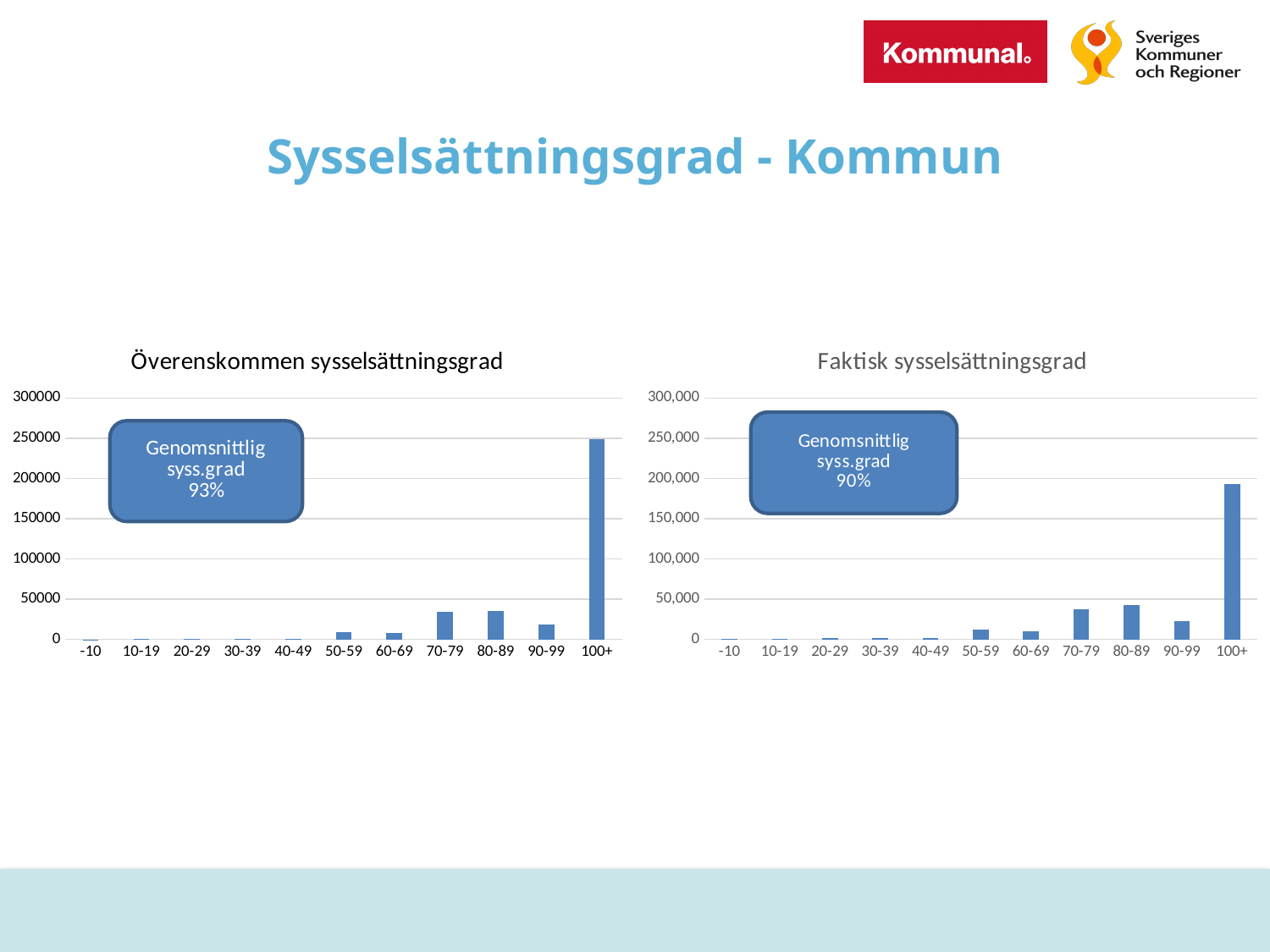
In the 'Överenskommen sysselsättningsgrad' chart, which category has the highest value? 100+ How many categories are shown on the x axis of the 'Faktisk sysselsättningsgrad' chart? 11 In the 'Överenskommen sysselsättningsgrad' chart, is the value for 70-79 greater or less than 50000? less In the 'Överenskommen sysselsättningsgrad' chart, is the value for 100+ greater or less than 200000? greater What kind of chart is the 'Överenskommen sysselsättningsgrad' chart? bar chart In the 'Faktisk sysselsättningsgrad' chart, which is larger: the value for 80-89 or the value for 90-99? 80-89 In the 'Faktisk sysselsättningsgrad' chart, which category has the highest value? 100+ In the 'Faktisk sysselsättningsgrad' chart, is the value for 100+ greater or less than 150,000? greater In the 'Överenskommen sysselsättningsgrad' chart, which is larger: the value for 50-59 or the value for 70-79? 70-79 What average employment rate (Genomsnittlig syss.grad) is shown in the box on the 'Faktisk sysselsättningsgrad' chart? 90% What average employment rate (Genomsnittlig syss.grad) is shown in the box on the 'Överenskommen sysselsättningsgrad' chart? 93%